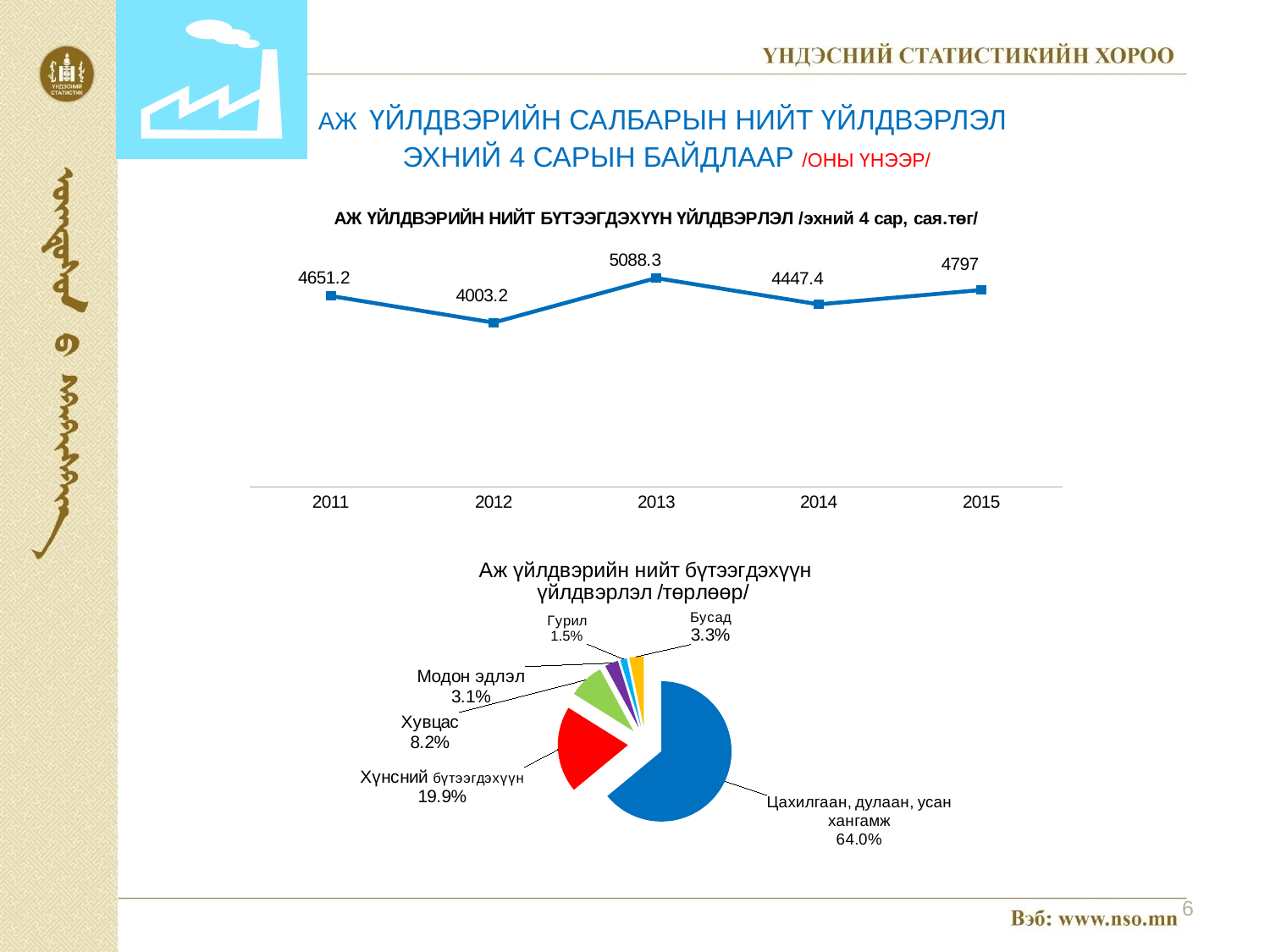
In the top line chart, which year has the highest value? 2013 In the top line chart, what is the value for 2015? 4797 In the top line chart, which is larger, the value for 2011 or the value for 2014? 2011 In the top line chart, what is the value for 2013? 5088.3 How many slices does the bottom pie chart have? 6 What type of chart is the top chart on the slide? line chart In the bottom pie chart, which category has the largest slice? Цахилгаан, дулаан, усан хангамж How many years are plotted in the top line chart? 5 In the top line chart, what is the difference between the 2013 and 2012 values? 1085.1 In the top line chart, which year has the lowest value? 2012 In the top line chart, does the value rise or fall from 2011 to 2012? fall In the bottom pie chart, what share does Хүнсний бүтээгдэхүүн have? 19.9%